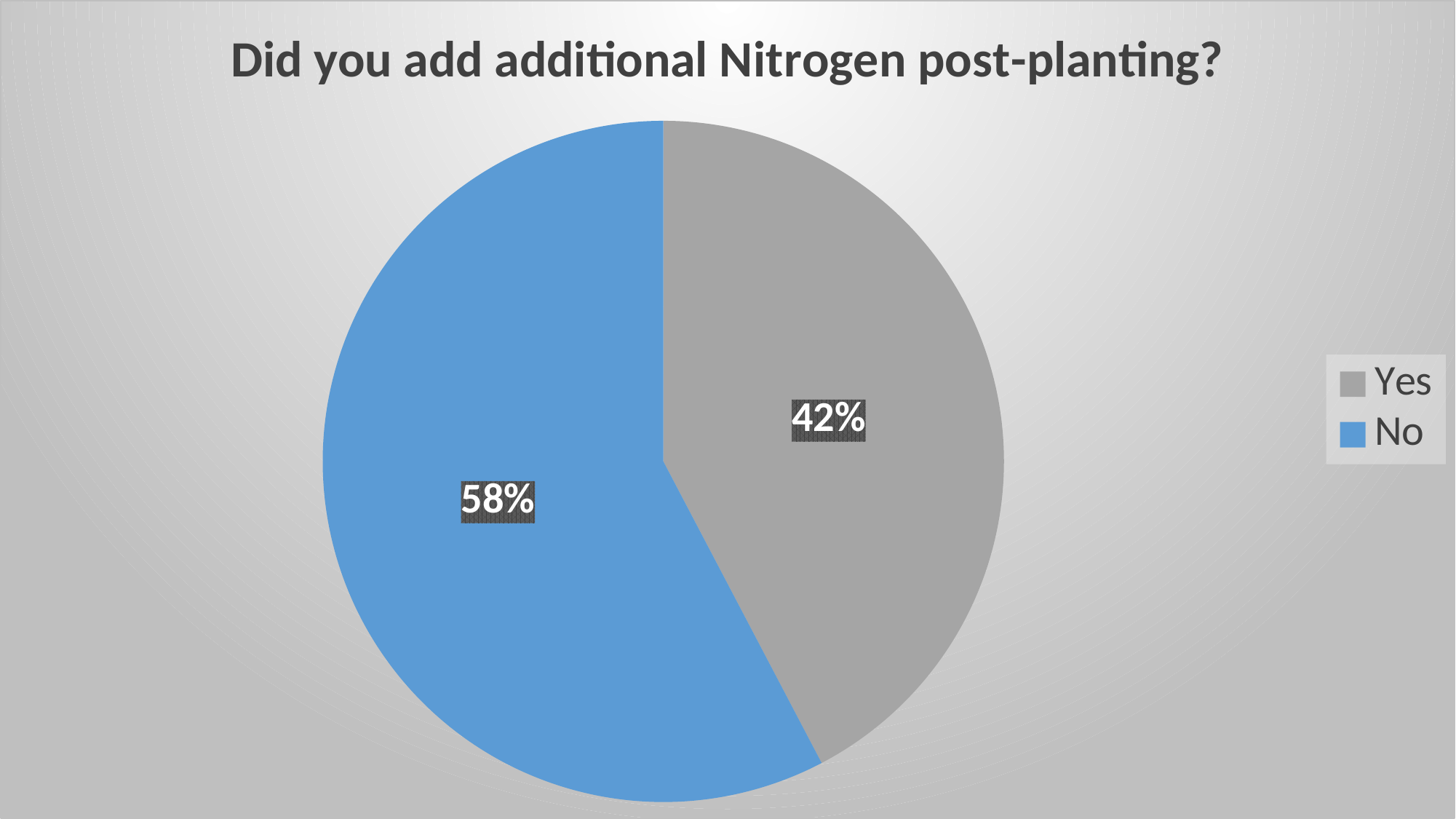
What is the title of the chart? Did you add additional Nitrogen post-planting? What percentage of respondents answered Yes? 42% What is the difference in percentage points between the No and Yes slices? 16 What percentage of respondents answered No? 58% What share of the pie does the Yes slice represent? 42% Which response has the smallest share of the pie? Yes Which slice is larger, Yes or No? No Which response has the largest share of the pie? No What kind of chart is shown on the slide? pie chart What colour is the No slice? blue How many entries does the legend list? 2 How many slices does the pie chart have? 2